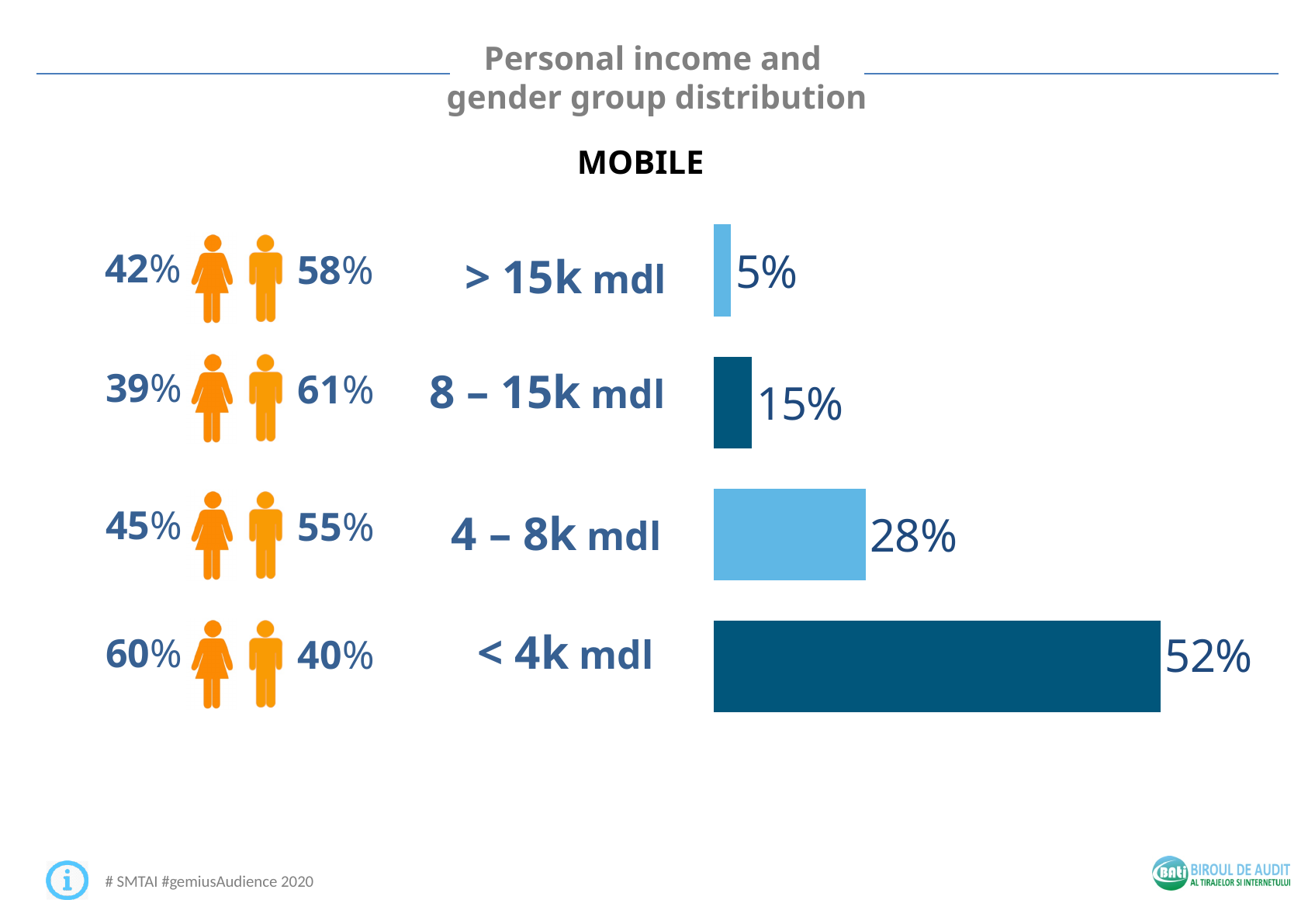
What percentage of the < 4k mdl income group is female? 60% Which income group has the smallest share of the mobile audience? > 15k mdl What share of the mobile audience has a personal income of < 4k mdl? 52% What percentage of the 8 – 15k mdl income group is male? 61% How many income groups are shown in the bar chart? 4 What is the difference in share between the < 4k mdl and 4 – 8k mdl income groups? 24% What kind of chart shows the income group distribution? Bar chart What is the title of the chart on the slide? Personal income and gender group distribution Which income group has the largest share of the mobile audience? < 4k mdl What share of the mobile audience has a personal income of > 15k mdl? 5% Which income group has a larger share: 8 – 15k mdl or 4 – 8k mdl? 4 – 8k mdl What share of the mobile audience has a personal income of 8 – 15k mdl? 15%